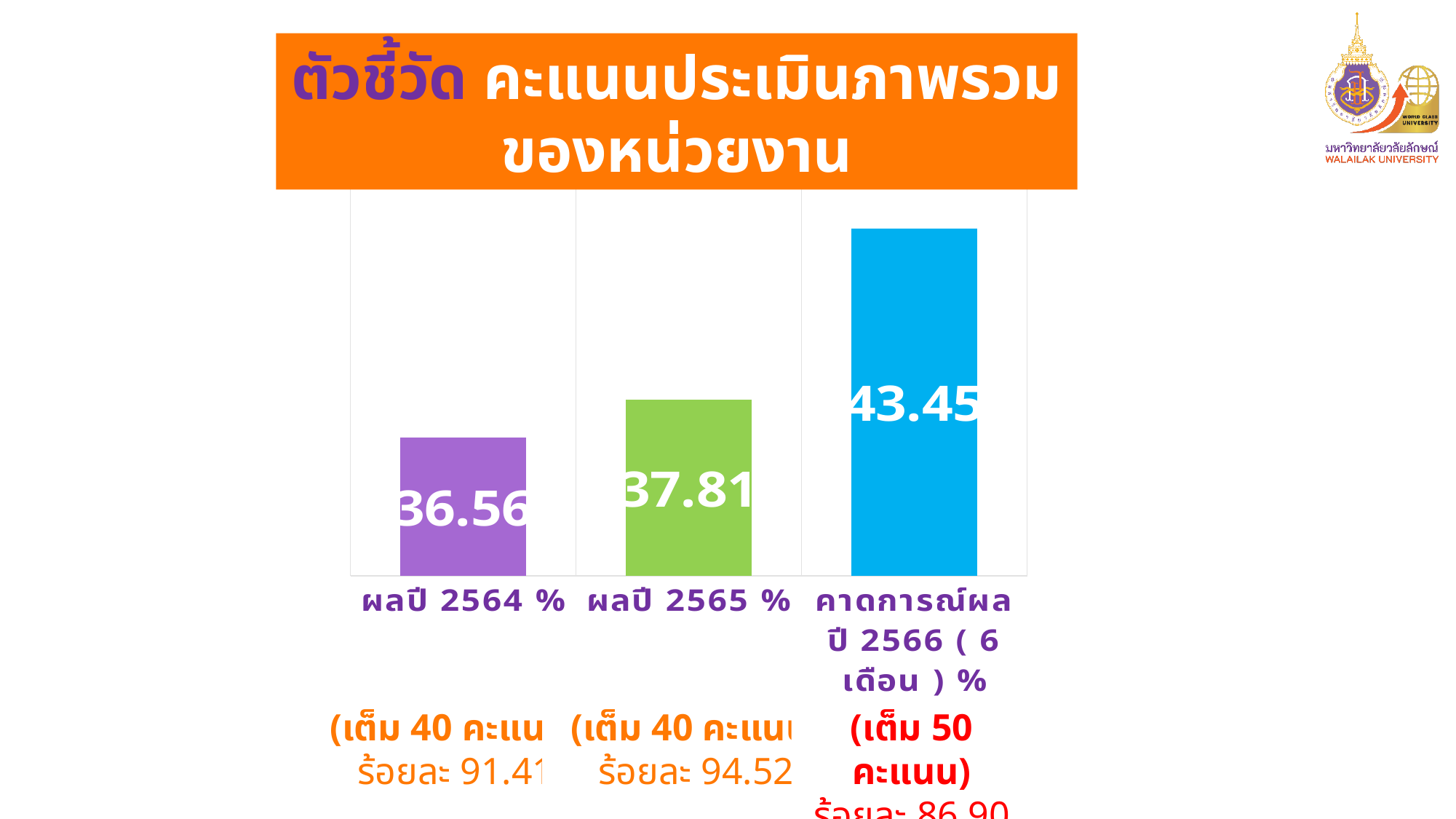
Do the values rise or fall from left to right across the categories? Rise What is the value of the bar for ผลปี 2564 %? 36.56 Which is larger, the value for ผลปี 2564 % or the value for ผลปี 2565 %? ผลปี 2565 % Which category has the highest bar? คาดการณ์ผล ปี 2566 (6 เดือน) % What is the difference between the values for คาดการณ์ผล ปี 2566 (6 เดือน) % and ผลปี 2565 %? 5.64 What kind of chart is shown on the slide? Bar chart What is the difference between the values for ผลปี 2565 % and ผลปี 2564 %? 1.25 How many bars are shown in the chart? 3 Which category has the lowest bar? ผลปี 2564 % What is the value of the bar for คาดการณ์ผล ปี 2566 (6 เดือน) %? 43.45 What is the value of the bar for ผลปี 2565 %? 37.81 What colour is the bar for คาดการณ์ผล ปี 2566 (6 เดือน) %? Blue